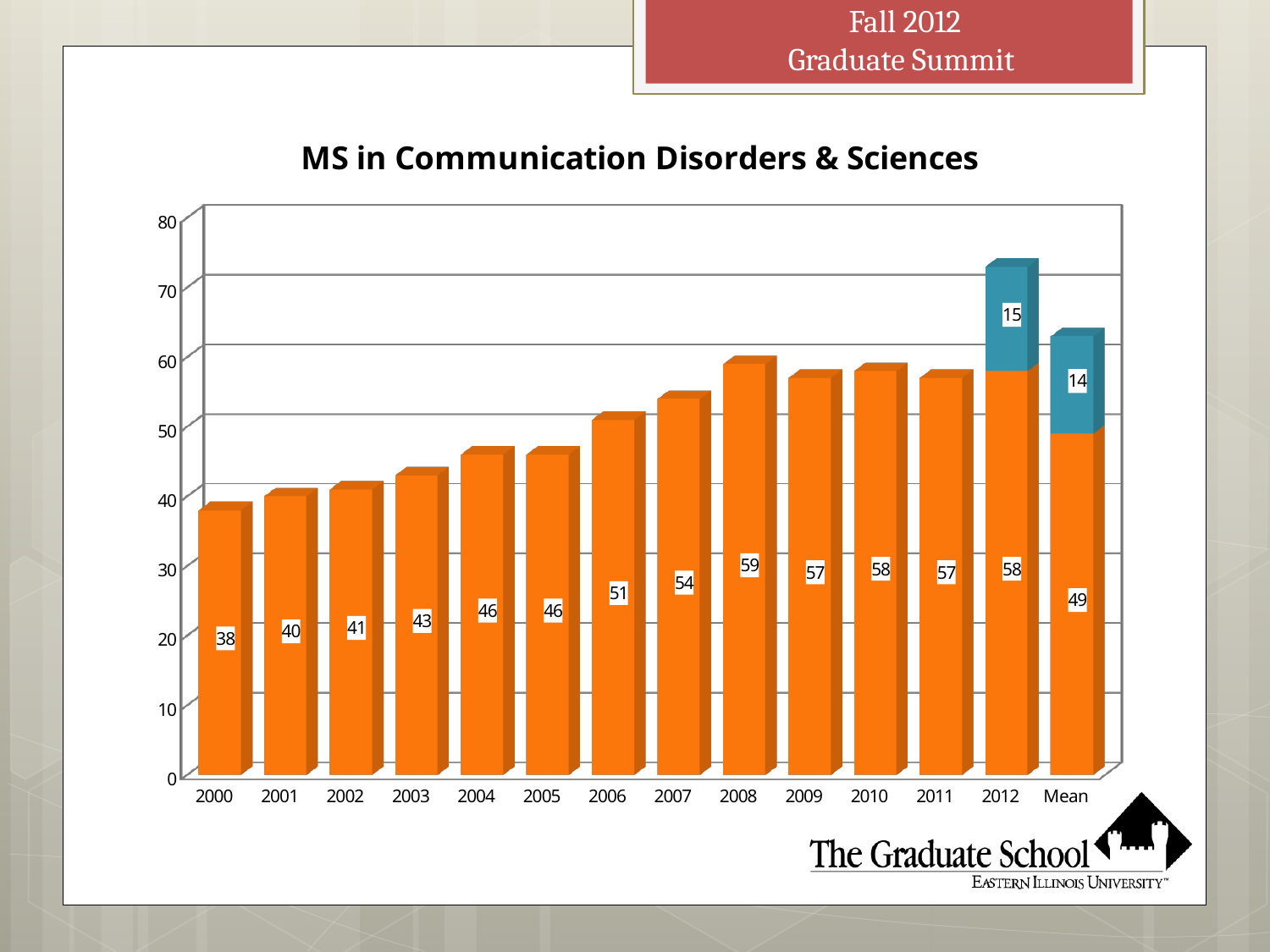
Which year has the highest orange segment value? 2008 What is the value of the blue segment on the 2012 bar? 15 What is the total height of the 2012 bar (orange plus blue)? 73 How many categories are shown on the x axis? 14 Which year has the lowest orange segment value? 2000 What is the title of the chart? MS in Communication Disorders & Sciences Which is larger, the orange value for 2006 or for 2007? 2007 What is the value of the orange segment for 2000? 38 What is the value of the orange segment for the Mean bar? 49 What is the difference between the orange values for 2008 and 2000? 21 What is the value of the orange segment for 2008? 59 What kind of chart is shown on the slide? Stacked bar chart